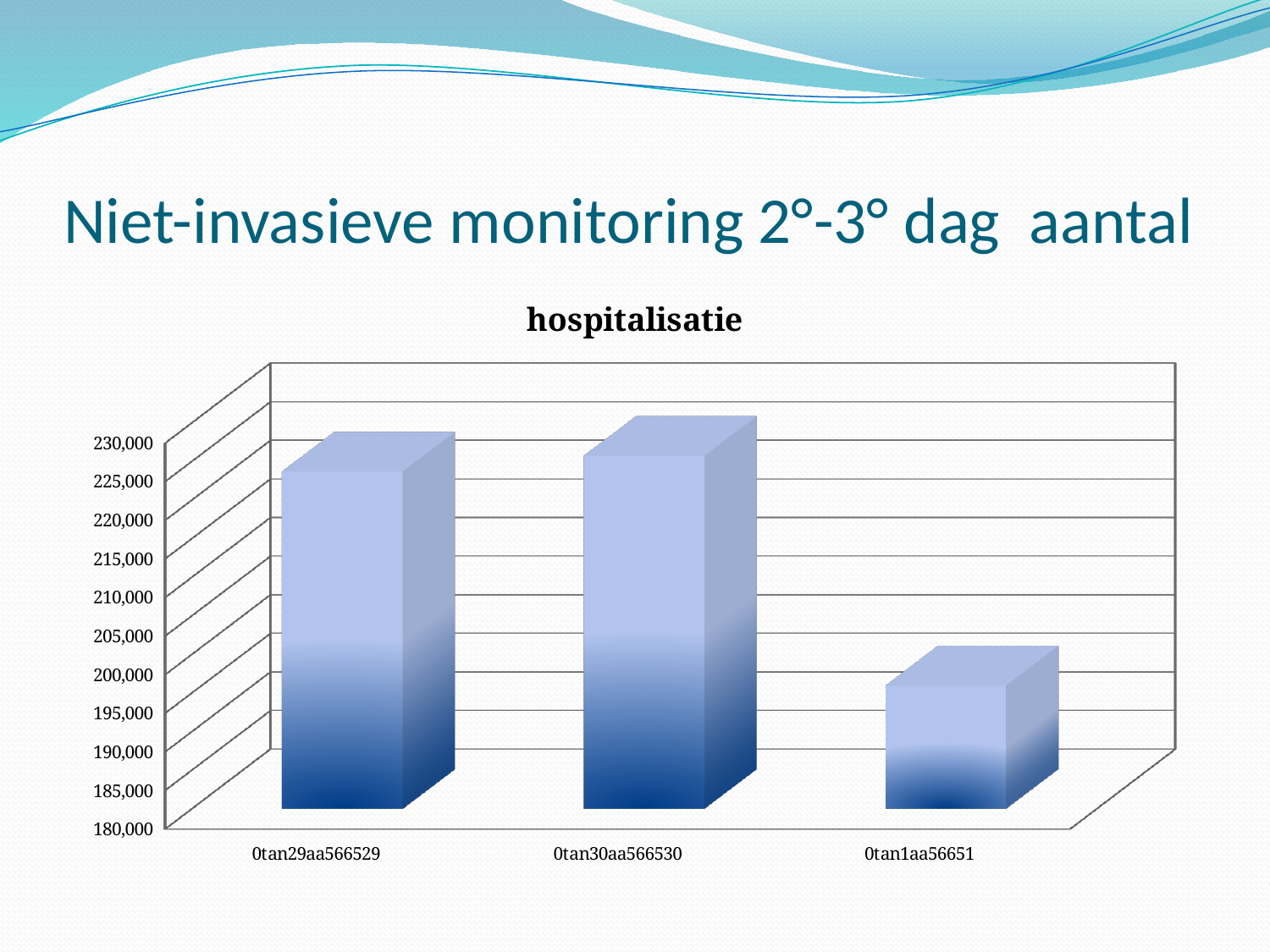
Does the value rise or fall from 0tan30aa566530 to 0tan1aa56651? fall Is the value for 0tan29aa566529 greater or less than 210,000? greater Which is larger, the value for 0tan29aa566529 or the value for 0tan1aa56651? 0tan29aa566529 What is the title of the chart? hospitalisatie Which category has the lowest value in the chart? 0tan1aa56651 How many categories are shown on the x axis of the chart? 3 Is the value for 0tan1aa56651 greater or less than 210,000? less What type of chart is shown on the slide? bar chart What is the lowest value shown on the y axis of the chart? 180,000 Is the value for 0tan30aa566530 greater or less than 215,000? greater Which category has the highest value in the chart? 0tan30aa566530